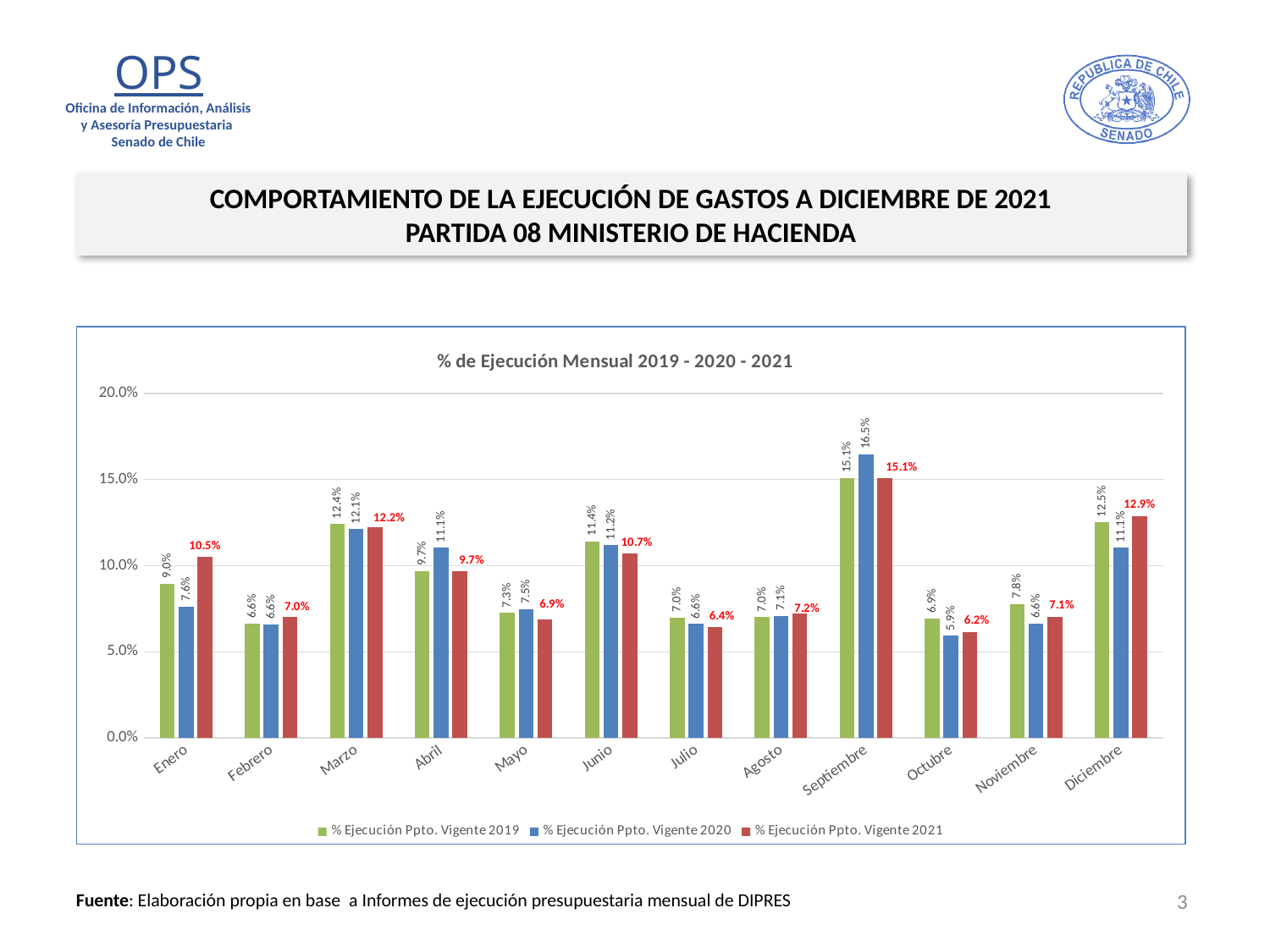
What is the title of the chart? % de Ejecución Mensual 2019 - 2020 - 2021 In Abril, which is larger: the 2020 value or the 2021 value? 2020 Is the value for % Ejecución Ppto. Vigente 2020 in Septiembre greater or less than 15.0%? greater How many series does the legend list? 3 Which month has the highest value for % Ejecución Ppto. Vigente 2021? Septiembre What kind of chart is shown? Bar chart What is the value for % Ejecución Ppto. Vigente 2021 in Enero? 10.5% What is the difference between the 2021 and 2019 values in Diciembre? 0.4% What is the value for % Ejecución Ppto. Vigente 2020 in Septiembre? 16.5% How many months are shown on the x axis? 12 What is the value for % Ejecución Ppto. Vigente 2019 in Marzo? 12.4% Which month has the lowest value for % Ejecución Ppto. Vigente 2020? Octubre